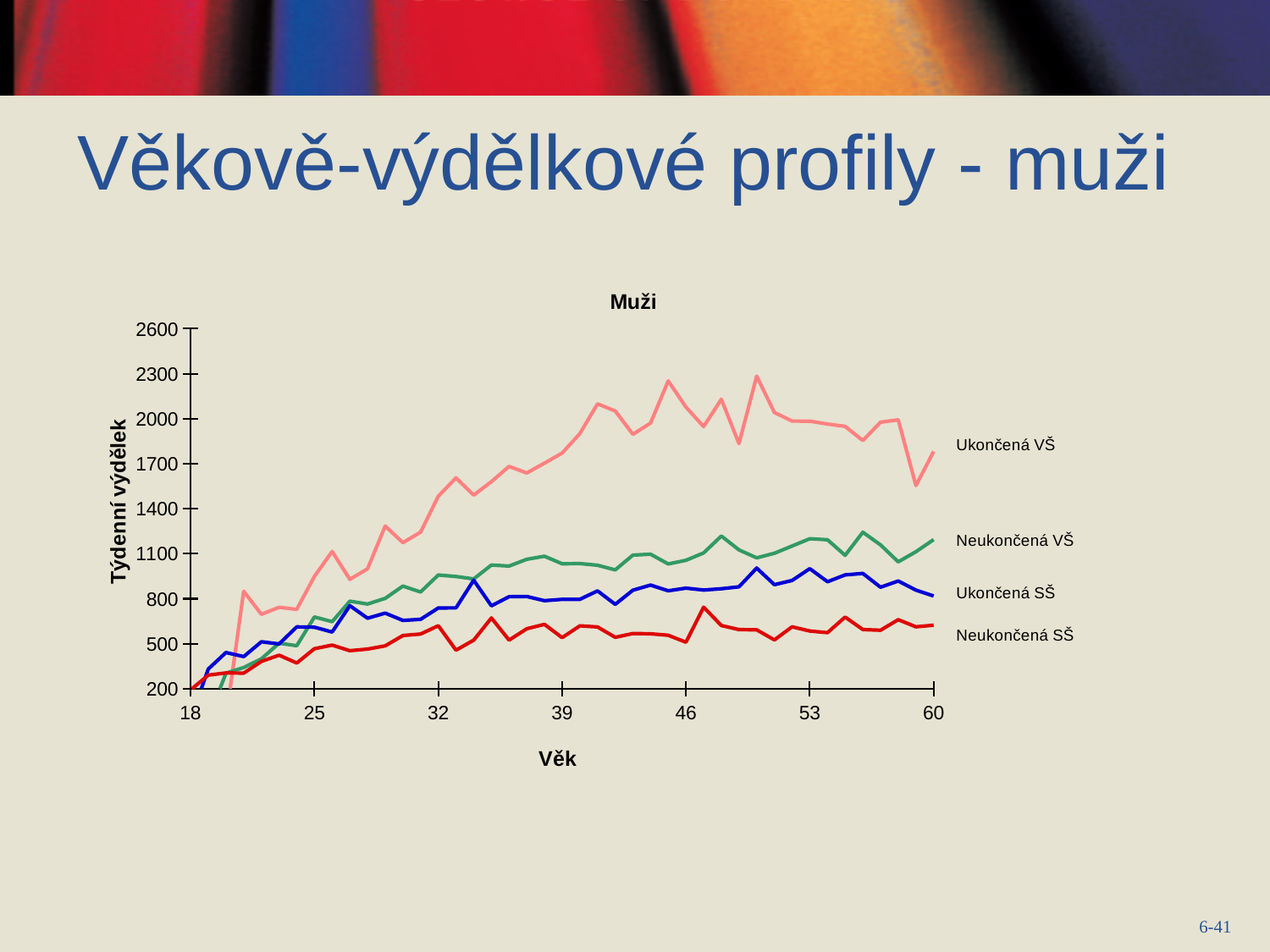
Which series has the lowest value at age 60? Neukončená SŠ Is the value for Neukončená SŠ at age 60 greater or less than 800? less At age 39, which is larger: Ukončená SŠ or Neukončená SŠ? Ukončená SŠ Is the value for Ukončená SŠ at age 60 greater or less than 1100? less How many series are labelled on the chart? 4 What kind of chart is shown on the slide? line chart Is the value for Ukončená VŠ at age 46 greater or less than 1700? greater What is the label on the vertical axis of the chart? Týdenní výdělek Does the Ukončená VŠ series generally rise or fall between ages 18 and 46? rise Which series has the highest value at age 60? Ukončená VŠ Which series reaches the highest value anywhere on the chart? Ukončená VŠ